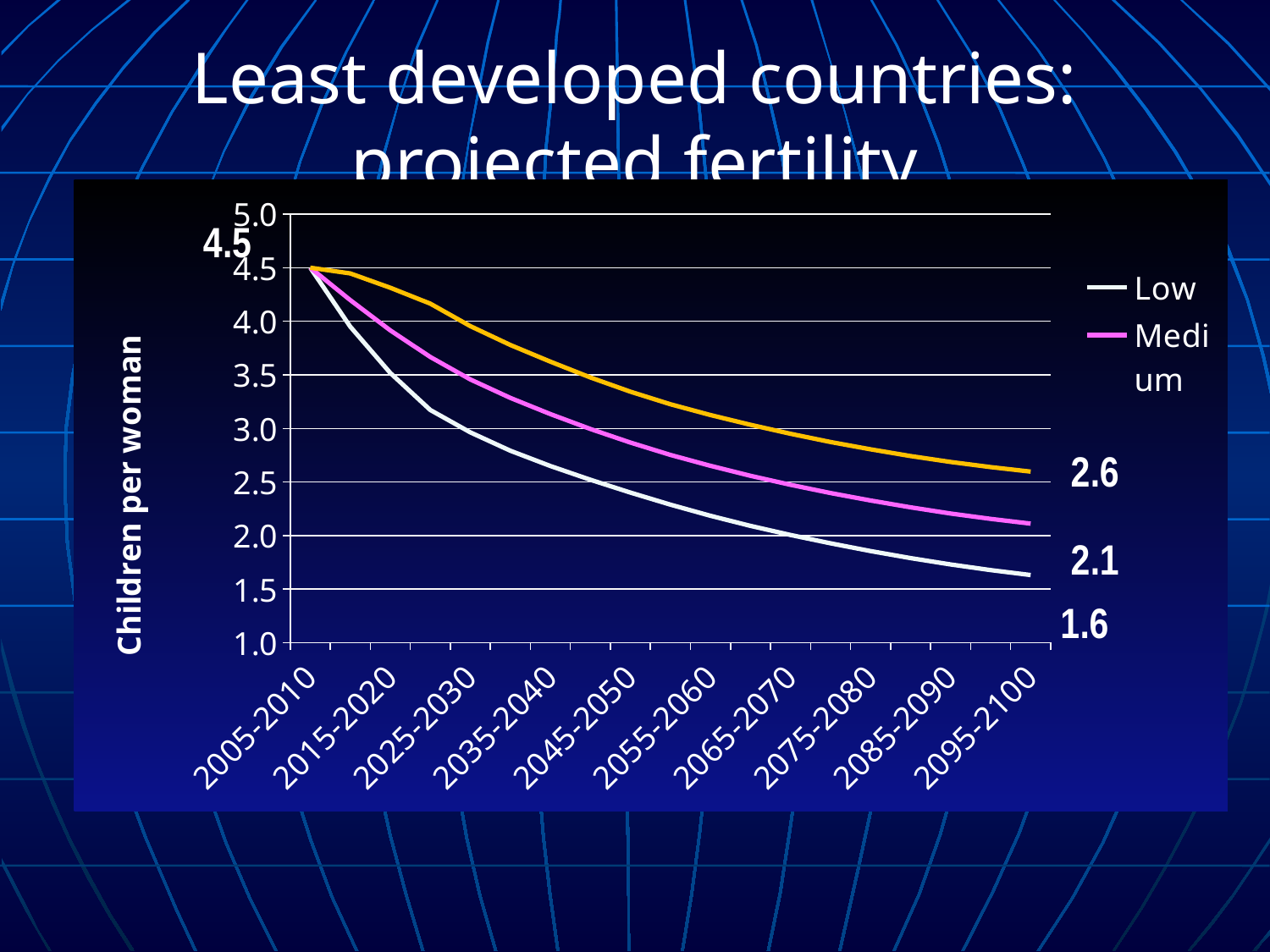
How many time periods are shown on the x axis? 10 What is the value of the Low series in 2095-2100? 1.6 Is the value for the Low series in 2045-2050 greater or less than 3.0? less How many lines are plotted on the chart? 3 By how much does the Low series decline from 2005-2010 to 2095-2100? 2.9 What kind of chart is shown on the slide? line chart What is the value of the Low series in 2005-2010? 4.5 In 2095-2100, which is larger, the Low value or the Medium value? Medium What is the label of the y axis? Children per woman What is the value of the Medium series in 2095-2100? 2.1 What is the difference between the Medium and Low values in 2095-2100? 0.5 Do the values of the Low series rise or fall from 2005-2010 to 2095-2100? fall